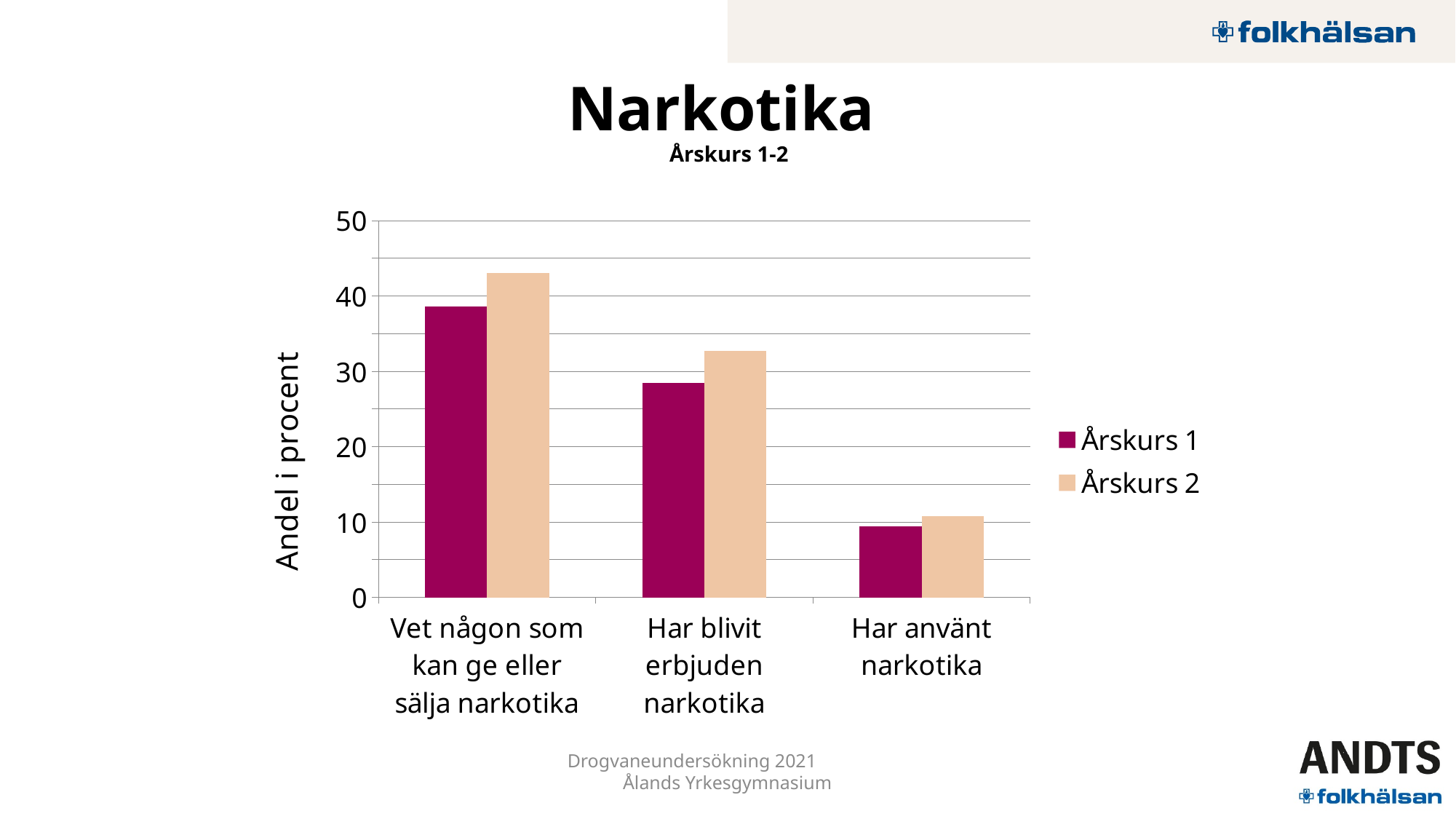
What is the title of the chart? Narkotika How many series does the legend list? 2 Which category has the highest value for Årskurs 1? Vet någon som kan ge eller sälja narkotika For 'Har blivit erbjuden narkotika', which series has the larger value, Årskurs 1 or Årskurs 2? Årskurs 2 Which category has the lowest value for Årskurs 2? Har använt narkotika Is the value for Årskurs 2 in 'Har blivit erbjuden narkotika' greater or less than 30? greater Is the value for Årskurs 2 in 'Vet någon som kan ge eller sälja narkotika' greater or less than 40? greater What is the label of the y axis? Andel i procent Is the value for Årskurs 1 in 'Har använt narkotika' greater or less than 20? less What kind of chart is shown on the slide? Bar chart How many categories are shown on the x axis of the chart? 3 For 'Vet någon som kan ge eller sälja narkotika', which series has the larger value, Årskurs 1 or Årskurs 2? Årskurs 2